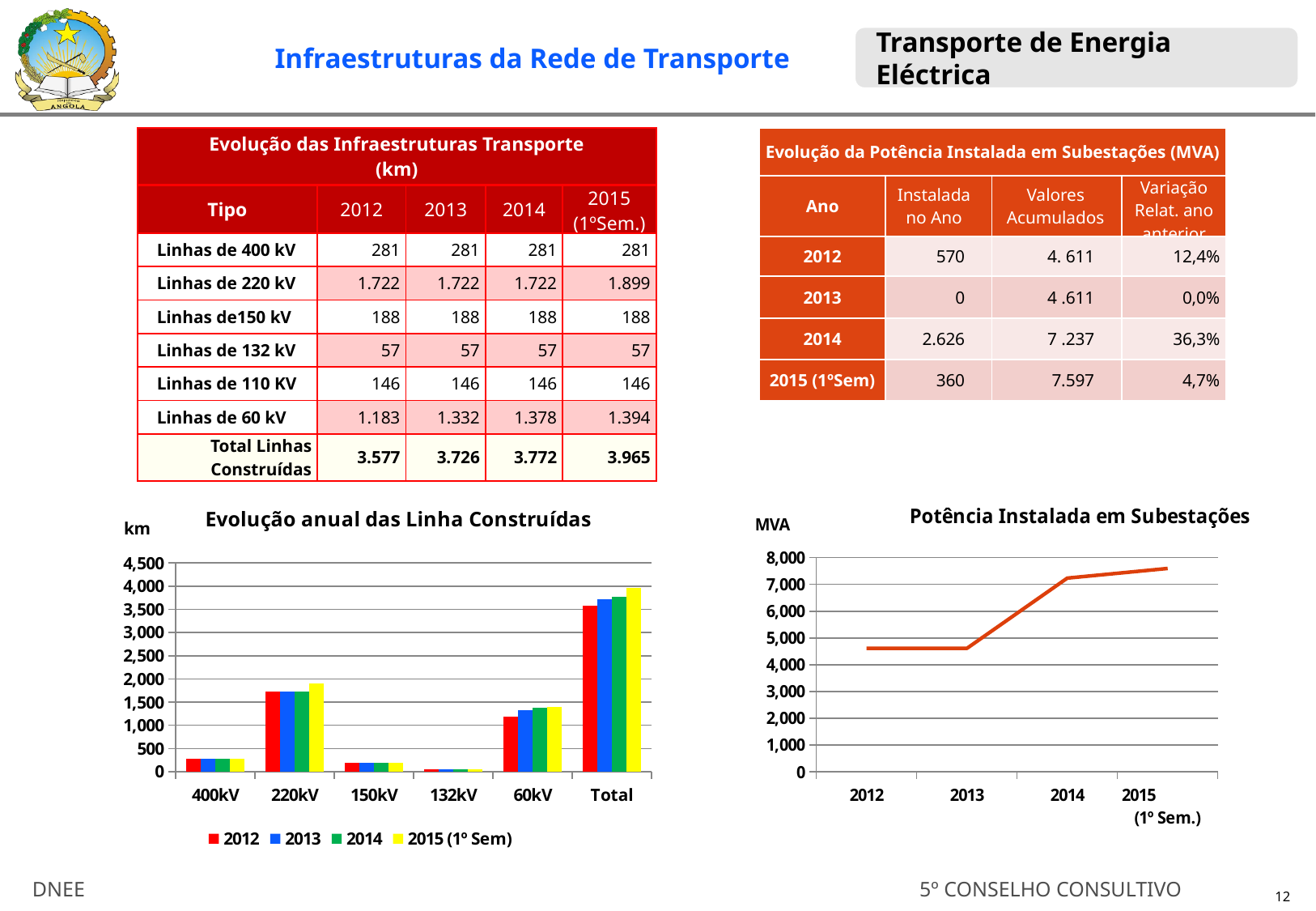
In the chart 'Evolução anual das Linha Construídas', is the 2015 (1º Sem) value for 220kV greater or less than 1,500? greater In the chart 'Potência Instalada em Subestações', which is larger, the value for 2013 or the value for 2014? 2014 In the chart 'Evolução anual das Linha Construídas', is the 2012 value for 60kV greater or less than 1,500? less In the chart 'Evolução anual das Linha Construídas', which category has the tallest bars? Total In the chart 'Potência Instalada em Subestações', how many points are plotted on the line? 4 What kind of chart is 'Potência Instalada em Subestações'? line chart In the chart 'Evolução anual das Linha Construídas', how many series does the legend list? 4 In the chart 'Potência Instalada em Subestações', is the value for 2012 greater or less than 5,000? less In the chart 'Potência Instalada em Subestações', do the values rise or fall from 2012 to 2015 (1º Sem.)? rise In the chart 'Evolução anual das Linha Construídas', which category has the lowest bars? 132kV In the chart 'Evolução anual das Linha Construídas', how many categories are shown on the x axis? 6 What kind of chart is 'Evolução anual das Linha Construídas'? bar chart